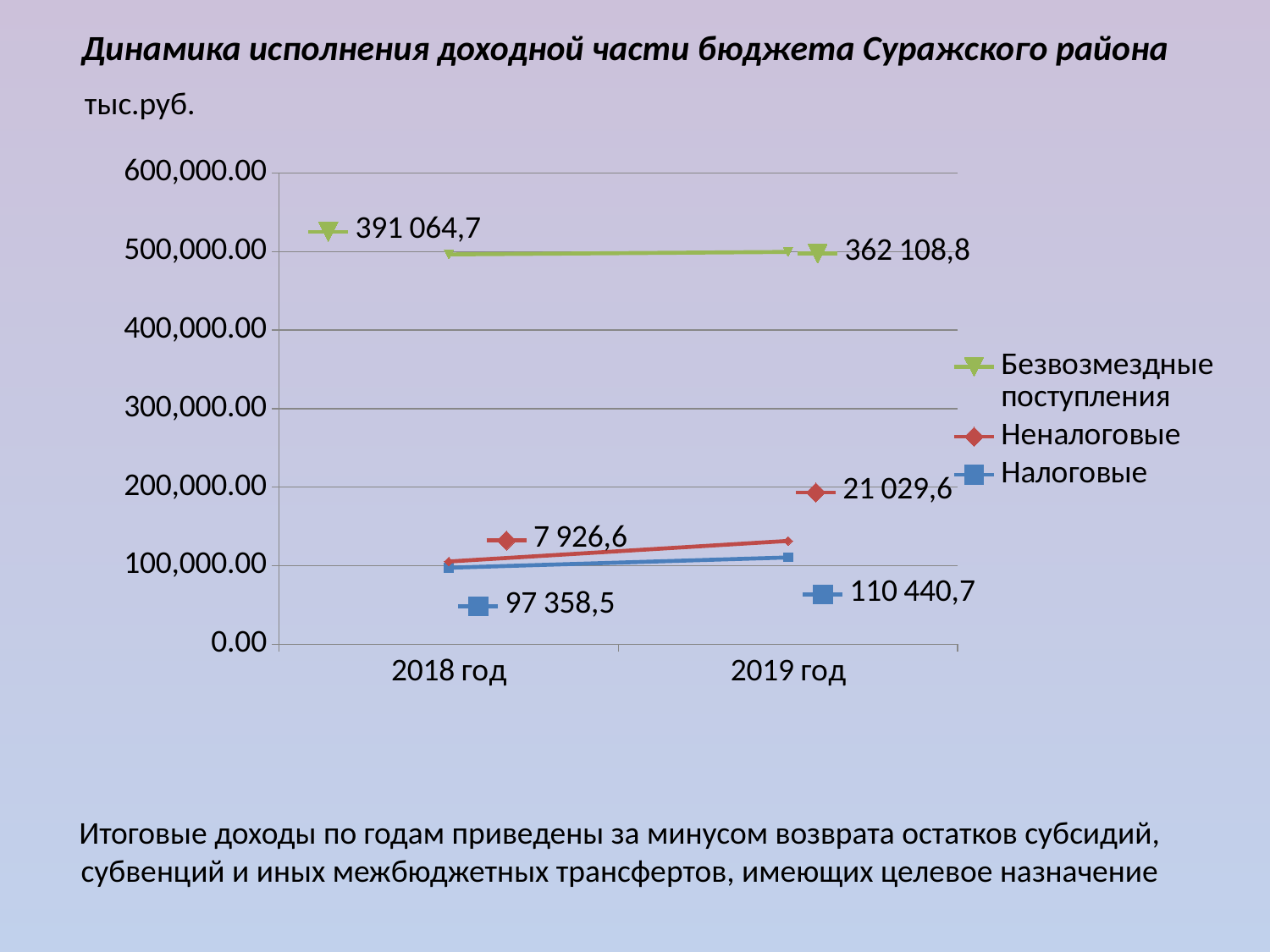
Is the value for Безвозмездные поступления larger in 2018 год or in 2019 год? 2018 год By how much did the value for Налоговые change from 2018 год to 2019 год? 13 082,2 Which series has the highest value in 2019 год? Безвозмездные поступления Do the values for Неналоговые rise or fall from 2018 год to 2019 год? rise What kind of chart is shown on the slide? line chart What is the value for Налоговые in 2019 год? 110 440,7 What is the value for Неналоговые in 2019 год? 21 029,6 How many years are shown on the x axis? 2 What is the value for Налоговые in 2018 год? 97 358,5 Which series has the lowest value in 2018 год? Неналоговые What is the value for Безвозмездные поступления in 2018 год? 391 064,7 How many series does the legend list? 3